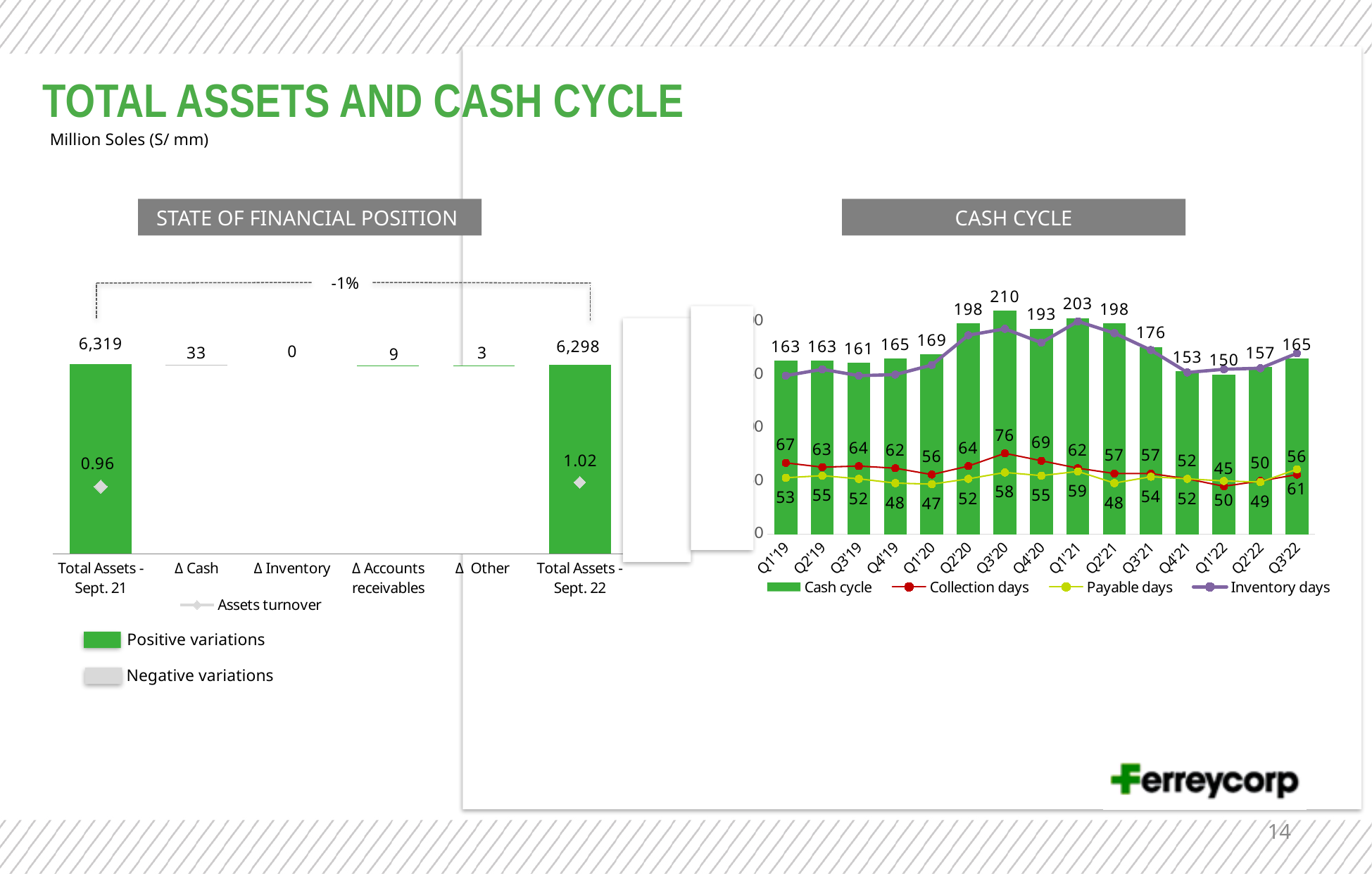
On the Cash Cycle chart, how many quarters are shown on the x axis? 15 On the State of Financial Position chart, what is the value for Total Assets - Sept. 21? 6,319 On the Cash Cycle chart, how many series does the legend list? 4 On the Cash Cycle chart, what is the Collection days value for Q3'20? 76 On the State of Financial Position chart, what percentage change is shown between Total Assets - Sept. 21 and Total Assets - Sept. 22? -1% On the State of Financial Position chart, what is the value shown for Δ Cash? 33 On the State of Financial Position chart, what is the value for Total Assets - Sept. 22? 6,298 On the State of Financial Position chart, which is larger, the Δ Accounts receivables value or the Δ Other value? Δ Accounts receivables On the Cash Cycle chart, which quarter has the highest cash cycle bar? Q3'20 On the Cash Cycle chart, what is the cash cycle value for Q3'22? 165 On the Cash Cycle chart, what is the Payable days value for Q3'22? 61 On the State of Financial Position chart, what is the Assets turnover value for Total Assets - Sept. 22? 1.02